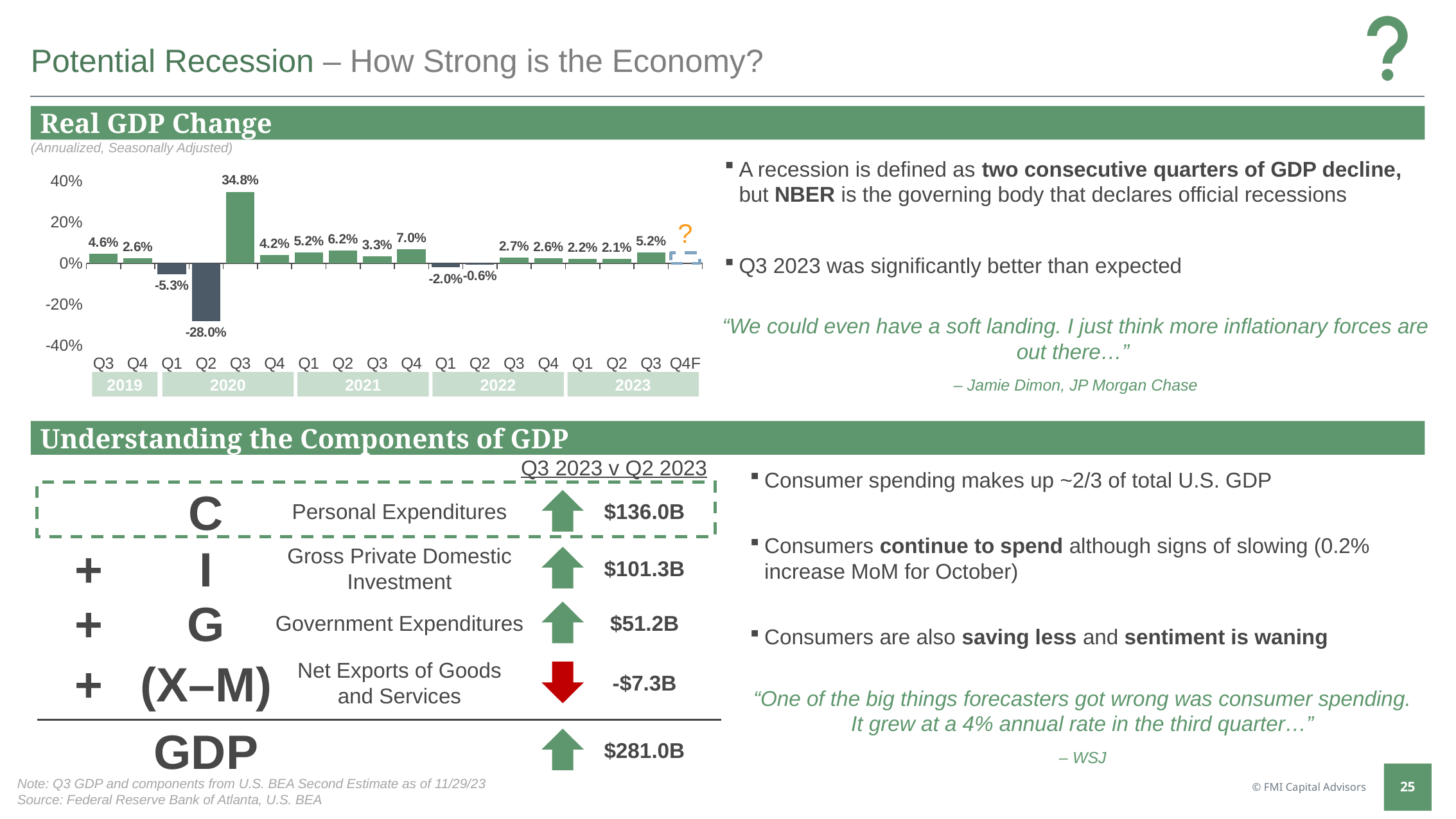
What is the Real GDP Change value for Q3 2023? 5.2% Is the Real GDP Change for Q3 2020 greater or less than 20%? greater What kind of chart is the Real GDP Change chart? Bar chart What is the difference between the Real GDP Change in Q3 2020 and Q2 2020? 62.8 percentage points What is the Real GDP Change value for Q1 2022? -2.0% Which is larger, the Real GDP Change for Q4 2021 or for Q2 2021? Q4 2021 Which quarter has the highest Real GDP Change in the chart? Q3 2020 What label is shown above the Q4F 2023 bar in the Real GDP Change chart? ? Which quarter has the lowest Real GDP Change in the chart? Q2 2020 Did Real GDP Change rise or fall from Q2 2023 to Q3 2023? Rise What is the Real GDP Change value for Q2 2020? -28.0% How many quarters are shown on the x axis of the Real GDP Change chart, including Q4F 2023? 18